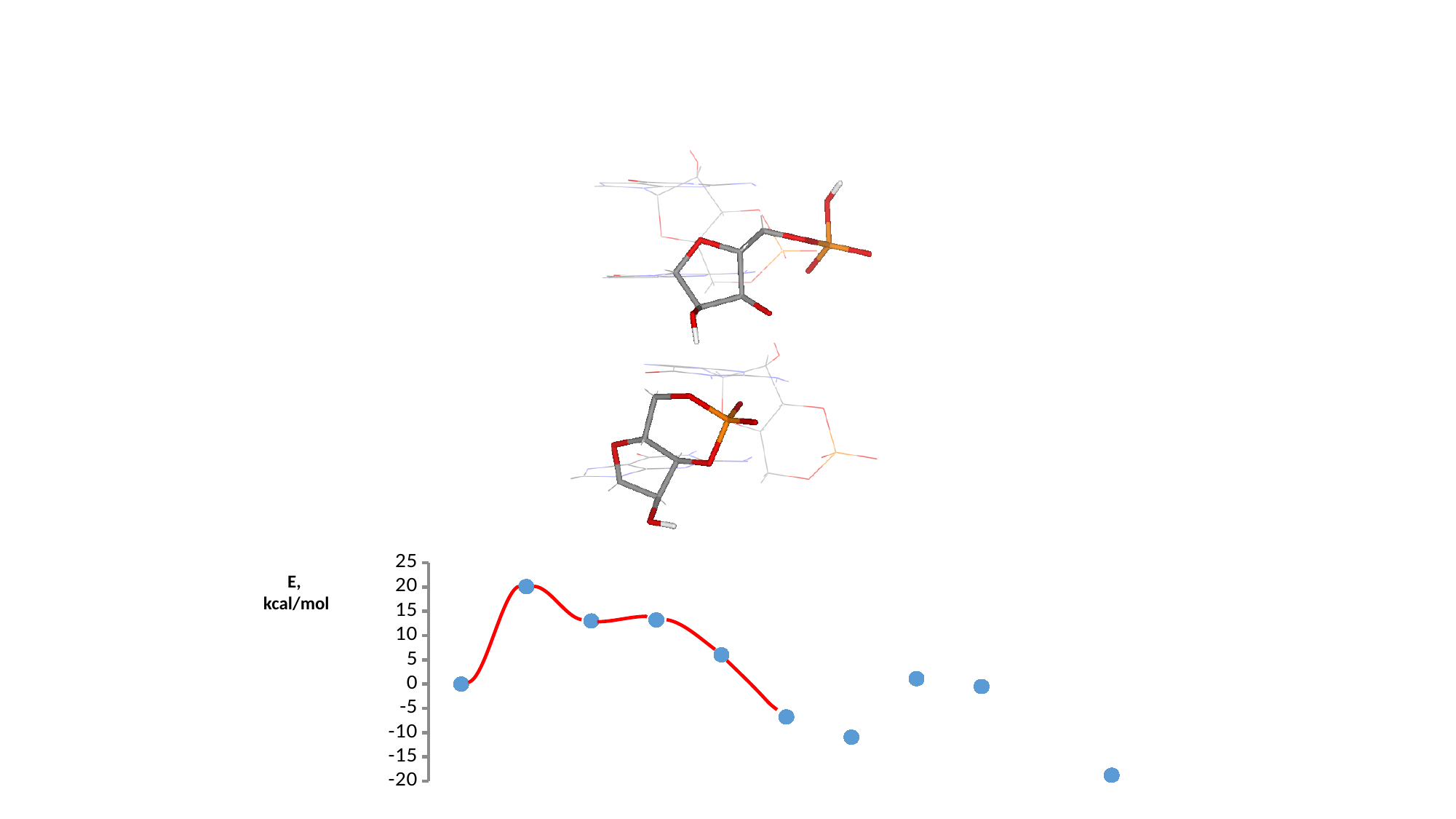
How many data points are plotted on the chart? 10 Which is larger, the value of the second data point or the value of the third data point? The second data point Is the value of the sixth data point (the end of the red curve) greater or less than -5? less Is the value of the rightmost data point greater or less than -15? less What is the label of the vertical axis of the chart? E, kcal/mol Which data point has the lowest energy value? The last (rightmost) point How many data points lie on the red curve? 6 Which data point has the highest energy value? The second point Is the value of the third data point greater or less than 10? greater What is the value of the first (leftmost) data point? 0 What kind of chart is shown at the bottom of the slide? Scatter chart with a fitted line